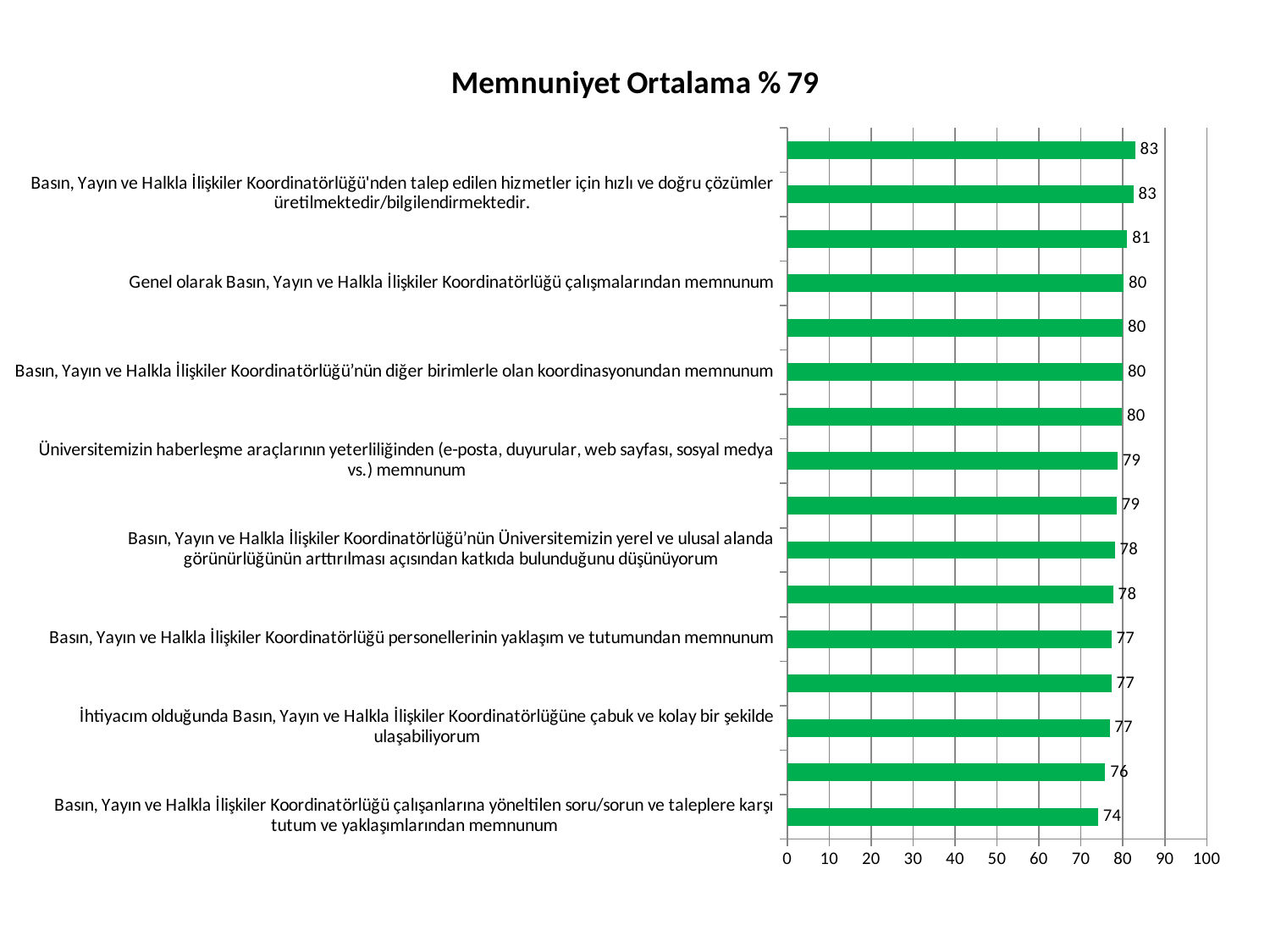
Which is larger: the value for "Genel olarak Basın, Yayın ve Halkla İlişkiler Koordinatörlüğü çalışmalarından memnunum" or the value for "Basın, Yayın ve Halkla İlişkiler Koordinatörlüğü personellerinin yaklaşım ve tutumundan memnunum"? Genel olarak Basın, Yayın ve Halkla İlişkiler Koordinatörlüğü çalışmalarından memnunum What is the value for "Genel olarak Basın, Yayın ve Halkla İlişkiler Koordinatörlüğü çalışmalarından memnunum"? 80 What is the lowest value shown on the chart? 74 Is the value for "Basın, Yayın ve Halkla İlişkiler Koordinatörlüğü'nden talep edilen hizmetler için hızlı ve doğru çözümler üretilmektedir/bilgilendirmektedir." greater or less than 90? less What kind of chart is shown on the slide? bar chart What is the highest value shown on the chart? 83 What is the value for "İhtiyacım olduğunda Basın, Yayın ve Halkla İlişkiler Koordinatörlüğüne çabuk ve kolay bir şekilde ulaşabiliyorum"? 77 What is the difference between the highest value (83) and the lowest value (74) on the chart? 9 How many bars are plotted on the chart? 16 What is the value for "Üniversitemizin haberleşme araçlarının yeterliliğinden (e-posta, duyurular, web sayfası, sosyal medya vs.) memnunum"? 79 What is the value for "Basın, Yayın ve Halkla İlişkiler Koordinatörlüğü çalışanlarına yöneltilen soru/sorun ve taleplere karşı tutum ve yaklaşımlarından memnunum"? 74 What is the title of the chart? Memnuniyet Ortalama % 79